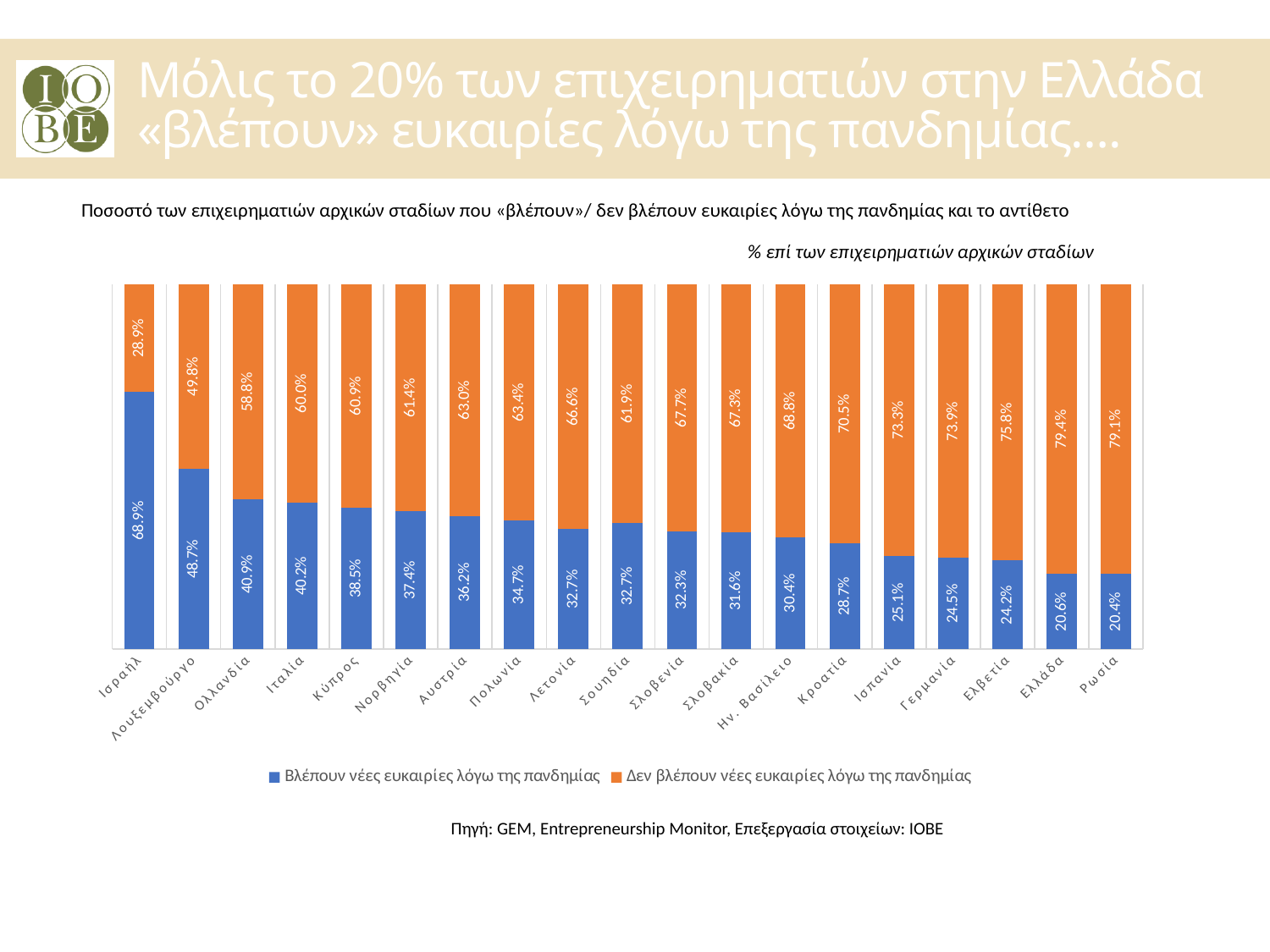
What is the difference between the 'Βλέπουν νέες ευκαιρίες' values for Ισραήλ and Ελλάδα? 48.3 percentage points Which country has the lowest share of entrepreneurs who see new opportunities due to the pandemic? Ρωσία Which country has the highest share of entrepreneurs who see new opportunities due to the pandemic? Ισραήλ How many series does the chart legend list? 2 What is the value of the 'Βλέπουν νέες ευκαιρίες λόγω της πανδημίας' series for Λουξεμβούργο? 48.7% What is the value of the 'Δεν βλέπουν νέες ευκαιρίες λόγω της πανδημίας' series for Ισραήλ? 28.9% Which country has the highest value for 'Δεν βλέπουν νέες ευκαιρίες λόγω της πανδημίας'? Ελλάδα Which is larger for Κύπρος: the share that sees new opportunities or the share that does not? The share that does not see new opportunities (60.9%) What percentage of early-stage entrepreneurs in Ελλάδα see new opportunities due to the pandemic (Βλέπουν νέες ευκαιρίες λόγω της πανδημίας)? 20.6% How many countries are shown on the x axis of the chart? 19 What is the total of the stacked bar for Ελλάδα? 100.0% What type of chart is shown on the slide? Stacked bar chart